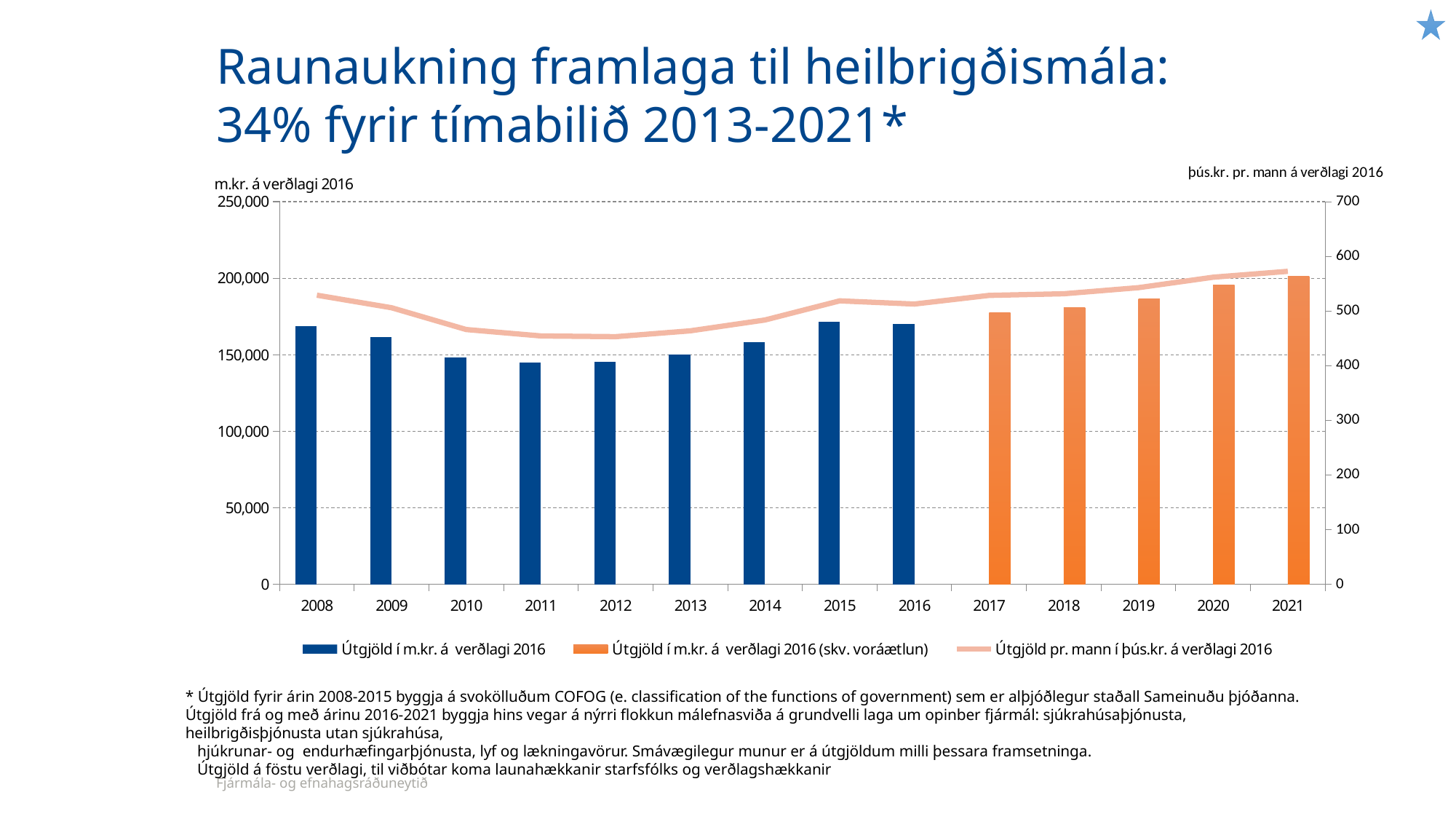
Which bar is taller, 2017 or 2021? 2021 Do the bar values rise or fall from 2012 to 2021? rise Does the line (Útgjöld pr. mann) rise or fall from 2008 to 2011? fall Is the bar value for 2020 greater or less than 200,000? less How many series does the chart legend list? 3 What kind of chart is shown on the slide? A bar chart combined with a line What is the label shown above the left vertical axis of the chart? m.kr. á verðlagi 2016 How many years are shown on the x axis of the chart? 14 Is the bar value for 2015 greater or less than 150,000? greater Is the bar value for 2008 greater or less than 150,000? greater Which bar is taller, 2008 or 2010? 2008 Which year has the highest bar in the chart? 2021